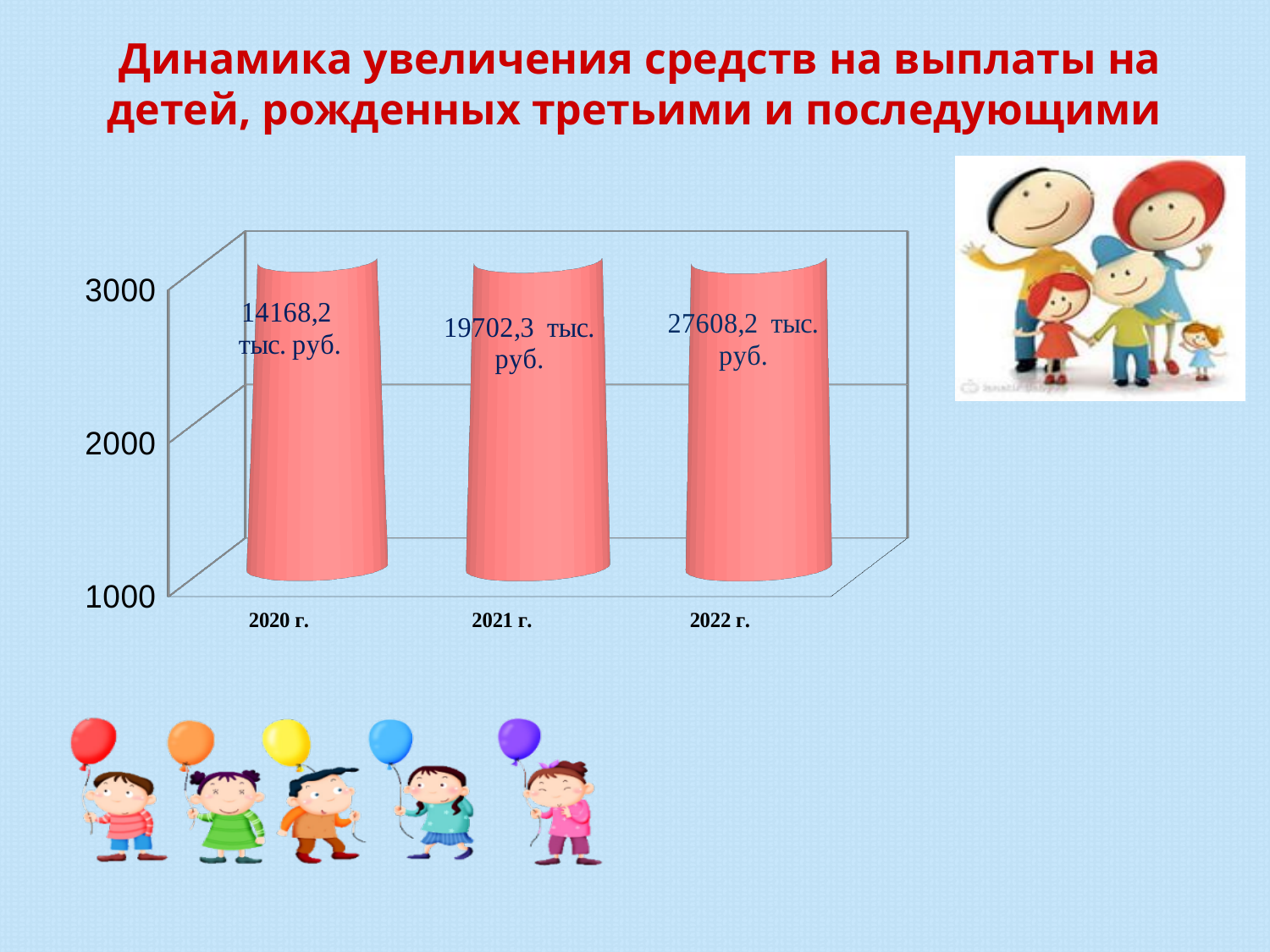
Which is larger, the value for 2021 г. or the value for 2022 г.? 2022 г. What is the title of the slide? Динамика увеличения средств на выплаты на детей, рожденных третьими и последующими By how much does the value for 2021 г. exceed the value for 2020 г.? 5534,1 тыс. руб. Which year has the lowest value according to the data labels? 2020 г. What is the value shown for 2022 г.? 27608,2 тыс. руб. What is the difference between the values for 2022 г. and 2021 г.? 7905,9 тыс. руб. What is the value shown for 2021 г.? 19702,3 тыс. руб. How many years (categories) are shown on the chart? 3 What is the value shown for 2020 г.? 14168,2 тыс. руб. Do the labelled values rise or fall from 2020 г. to 2022 г.? Rise What kind of chart is shown on the slide? Bar chart Which year has the highest value according to the data labels? 2022 г.